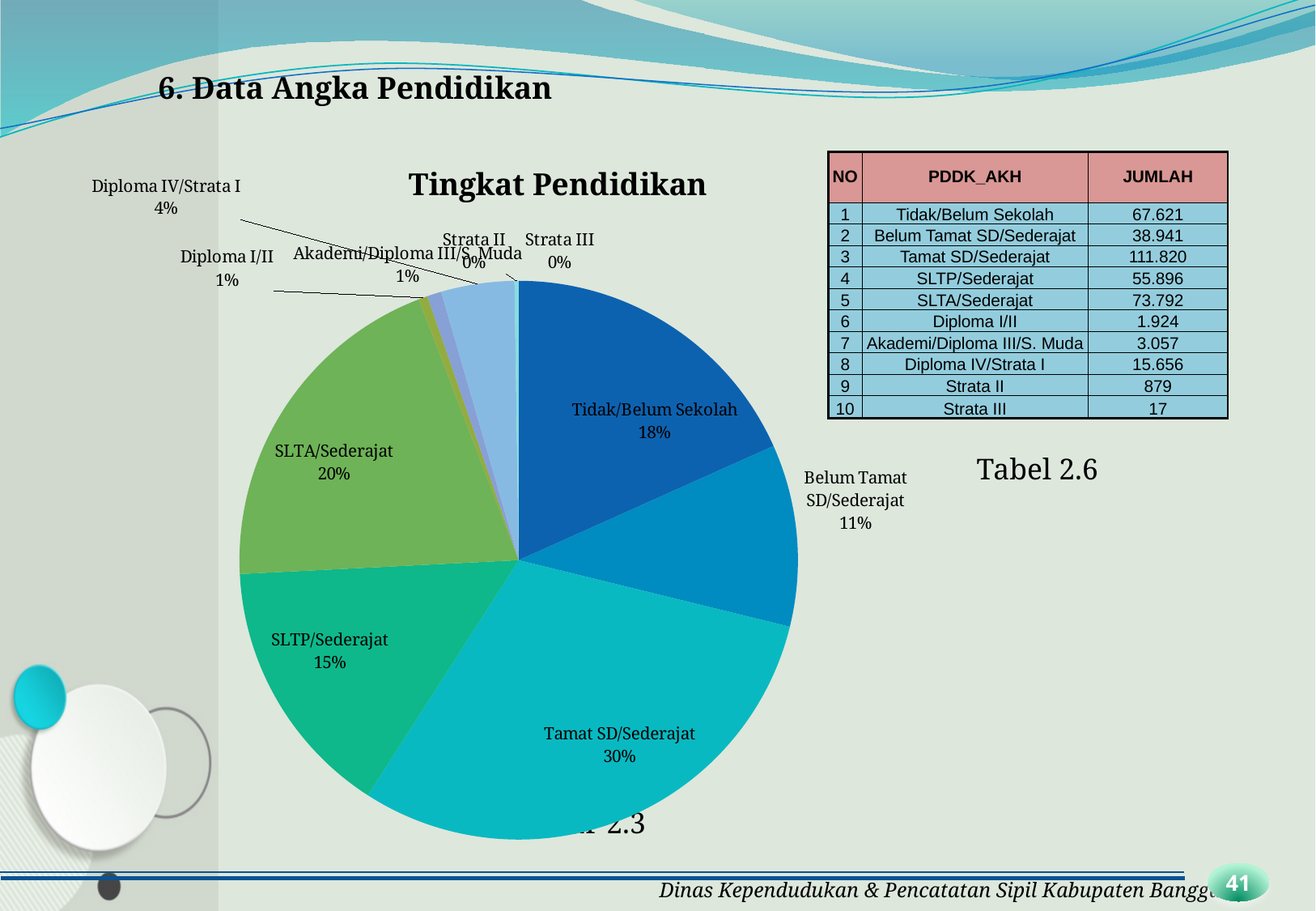
Which is larger, the share for SLTA/Sederajat or the share for SLTP/Sederajat? SLTA/Sederajat What share of the pie does SLTA/Sederajat represent? 20% What share of the pie does Diploma IV/Strata I represent? 4% What share of the pie does Tidak/Belum Sekolah represent? 18% What is the difference in percentage points between the Tamat SD/Sederajat share and the SLTA/Sederajat share? 10% How many slices does the pie chart have? 10 Which category has the largest slice of the pie? Tamat SD/Sederajat What kind of chart is shown on the slide? pie chart What is the title of the chart? Tingkat Pendidikan